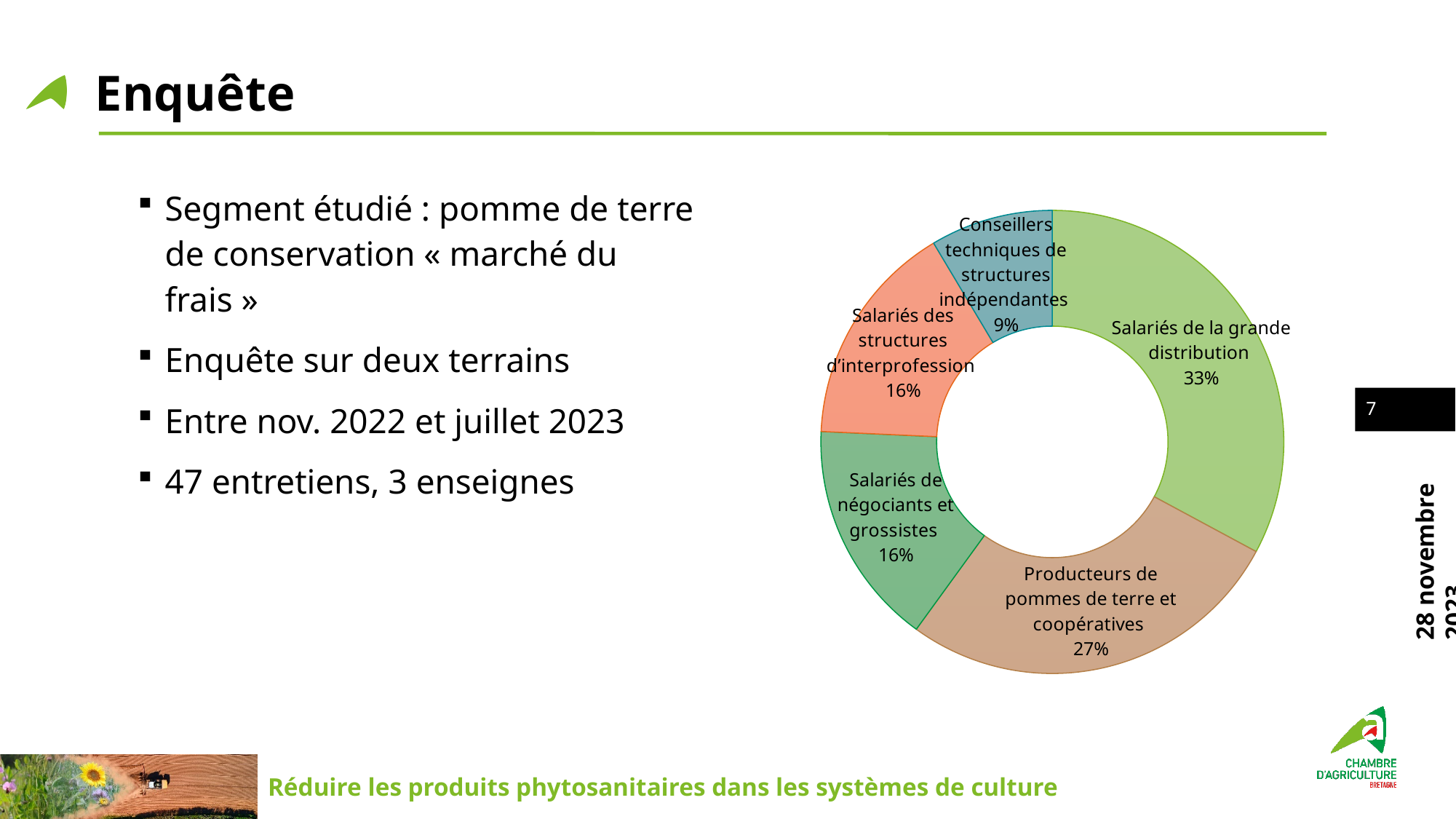
What share of the chart is 'Salariés de négociants et grossistes'? 16% What kind of chart is shown on the slide? Doughnut (pie) chart Which is larger: the share for 'Producteurs de pommes de terre et coopératives' or the share for 'Salariés des structures d'interprofession'? Producteurs de pommes de terre et coopératives Which category has the largest share of the chart? Salariés de la grande distribution What share of the chart is 'Salariés de la grande distribution'? 33% What share of the chart is 'Conseillers techniques de structures indépendantes'? 9% What is the combined share of 'Salariés des structures d'interprofession' and 'Salariés de négociants et grossistes'? 32% What share of the chart is 'Producteurs de pommes de terre et coopératives'? 27% How many categories does the chart show? 5 What colour is the slice for 'Salariés de la grande distribution'? Green Which category has the smallest share of the chart? Conseillers techniques de structures indépendantes What is the difference in percentage points between 'Salariés de la grande distribution' and 'Producteurs de pommes de terre et coopératives'? 6 percentage points